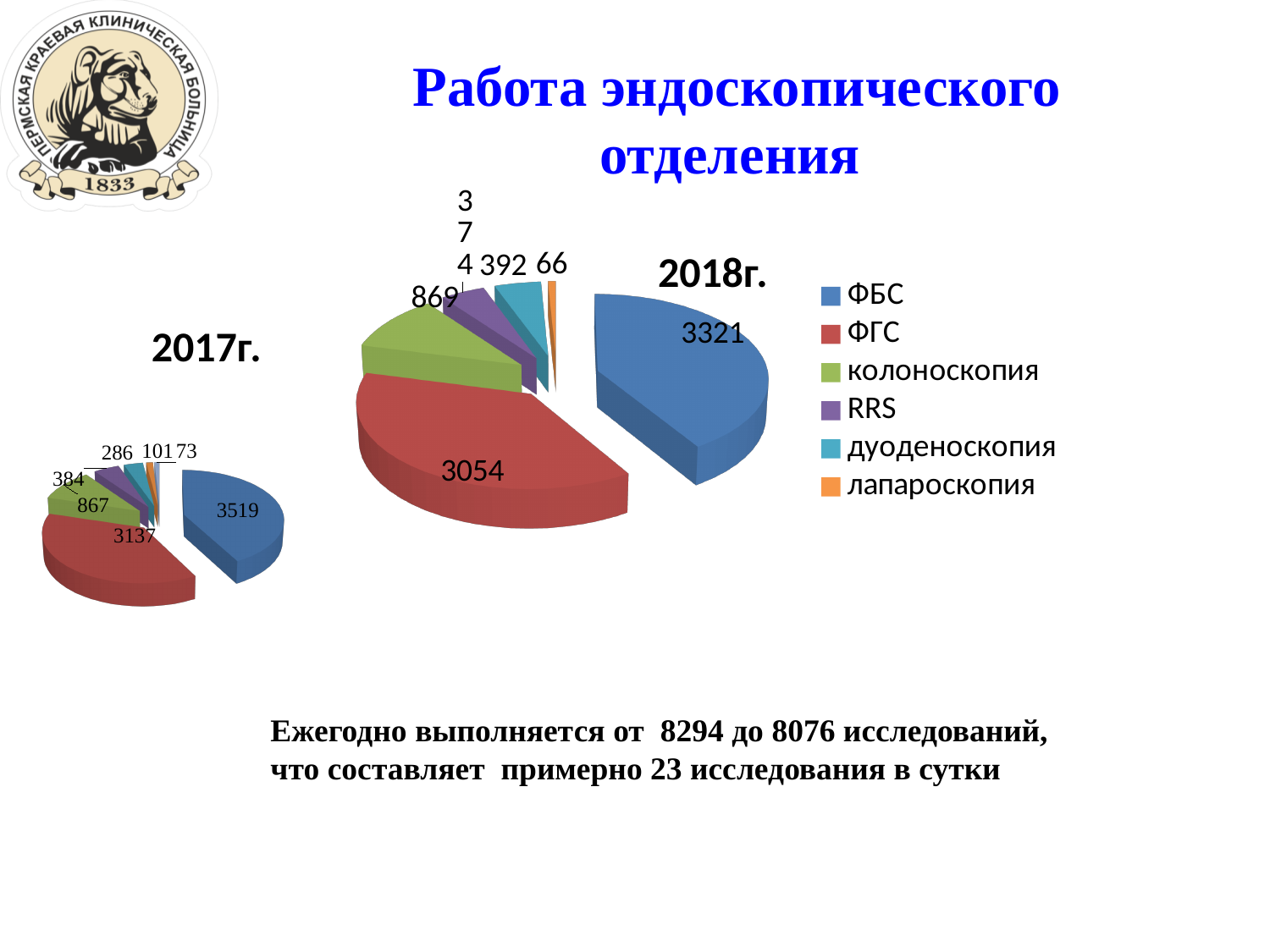
In the 2018г. chart, what is the value for ФГС? 3054 How many categories does the legend list? 6 In the 2017г. chart, what is the value for ФГС? 3137 What kind of chart is used to show the 2018г. data? pie chart In the 2017г. chart, what is the value for колоноскопия? 867 In the 2018г. chart, what is the difference between the values for ФБС and ФГС? 267 In the 2018г. chart, which category has the largest slice? ФБС In the 2018г. chart, what is the value for колоноскопия? 869 In the 2018г. chart, what is the value for ФБС? 3321 In the 2018г. chart, which category has the smallest slice? лапароскопия In the 2017г. chart, what is the value for ФБС? 3519 In the 2018г. chart, what is the value for лапароскопия? 66